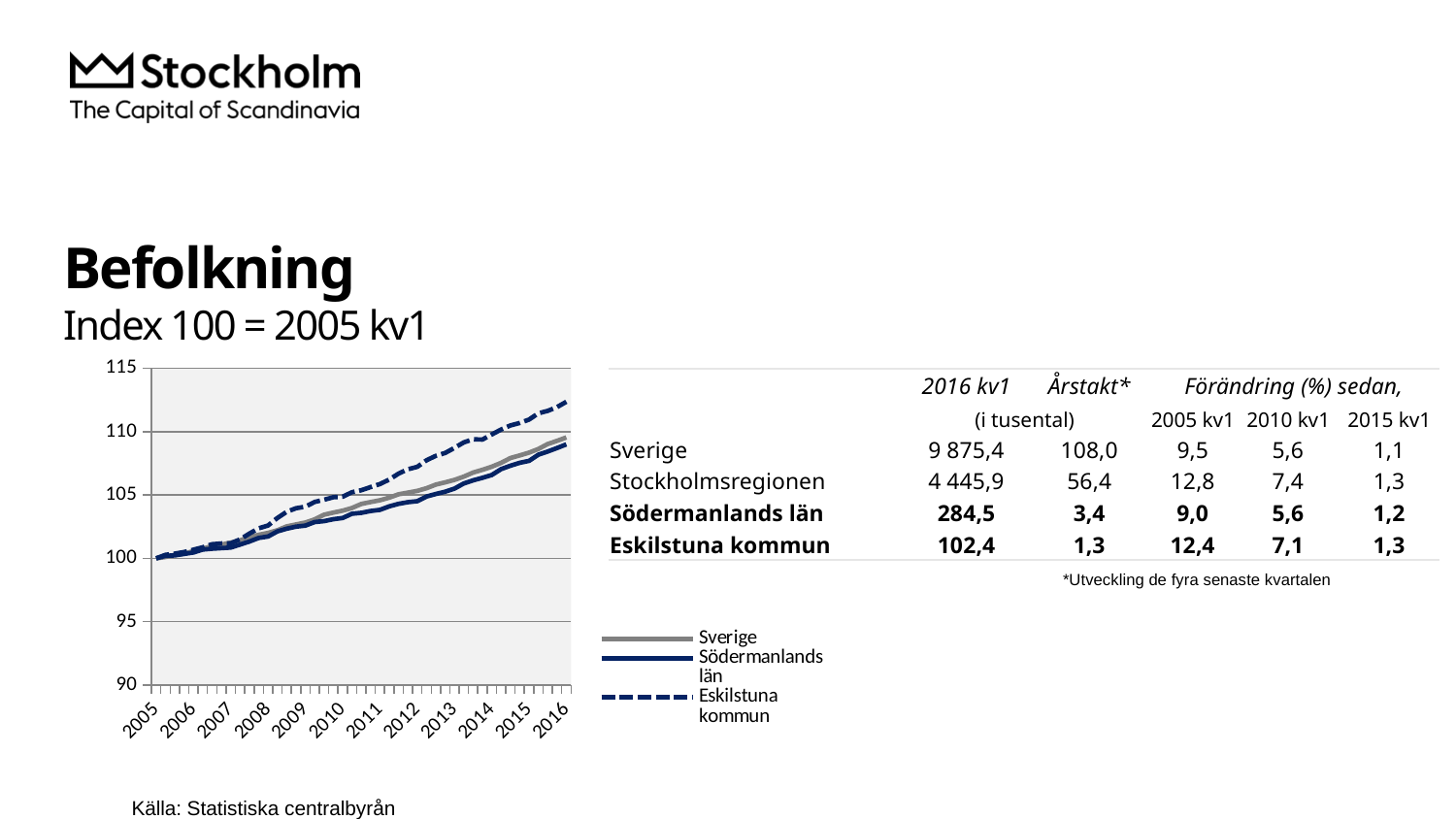
Do the index values in the chart rise or fall from 2005 to 2016? rise Which series is drawn with a dashed line in the chart? Eskilstuna kommun Is the value for Södermanlands län in 2010 greater or less than 105? less Is the value for Sverige in 2016 greater or less than 105? greater What kind of chart is shown on the slide? line chart What is the index value of all three series at the start of 2005? 100 How many years are labelled on the x axis of the chart? 12 Is the value for Eskilstuna kommun in 2016 greater or less than 110? greater How many series does the chart legend list? 3 Which series has the highest index value in 2016? Eskilstuna kommun What is the title of the chart on the slide? Befolkning